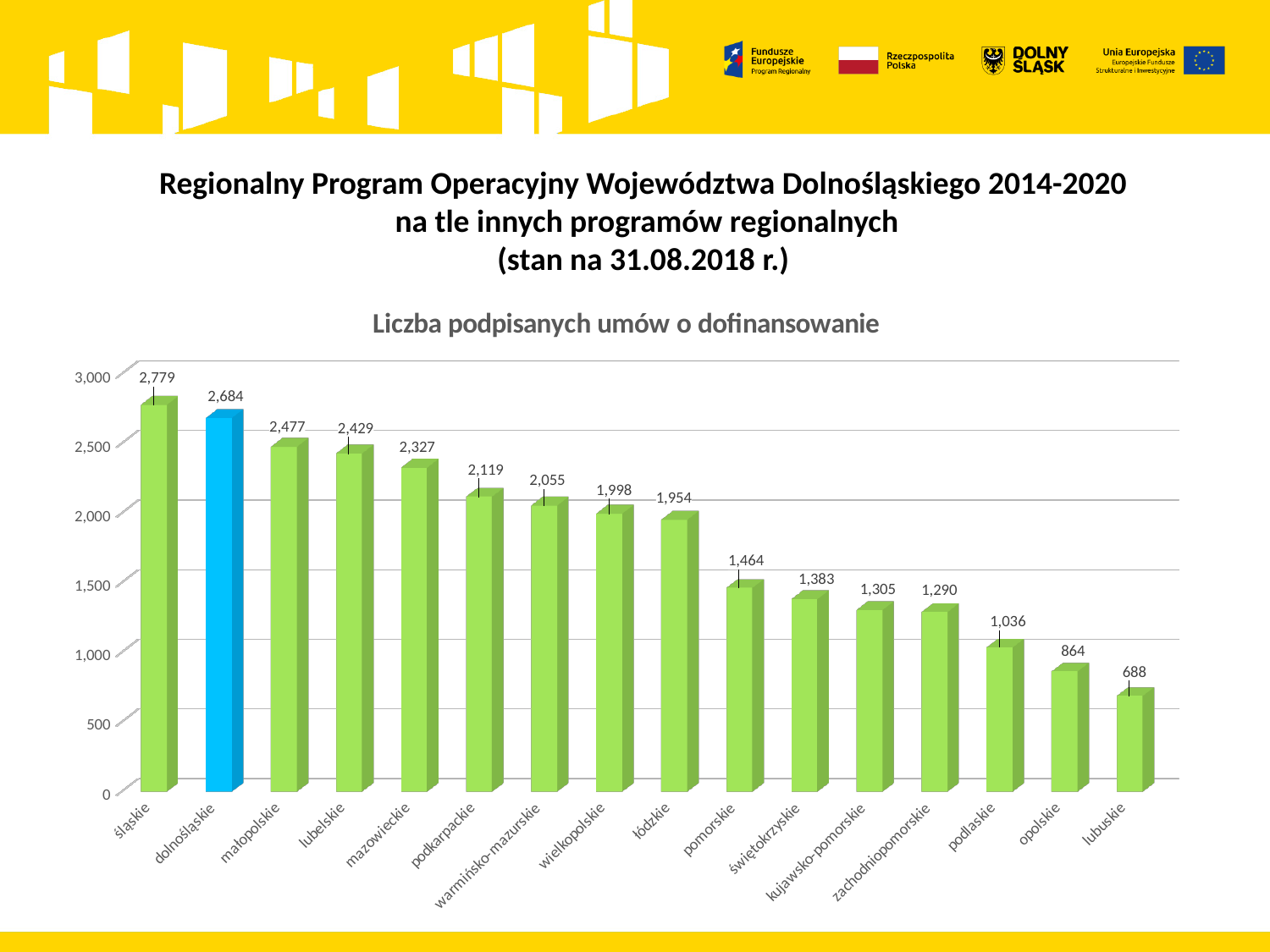
Which category has the lowest value? lubuskie What is the title of the chart? Liczba podpisanych umów o dofinansowanie What is the value for warmińsko-mazurskie? 2,055 What kind of chart is shown on the slide? bar chart Which is larger, the value for mazowieckie or the value for podkarpackie? mazowieckie Do the values rise or fall from left to right along the x axis? fall What is the value for dolnośląskie? 2,684 What is the difference between the values for śląskie and dolnośląskie? 95 How many categories are shown on the x axis? 16 What is the difference between the values for opolskie and lubuskie? 176 What is the value for pomorskie? 1,464 Which category has the highest value? śląskie